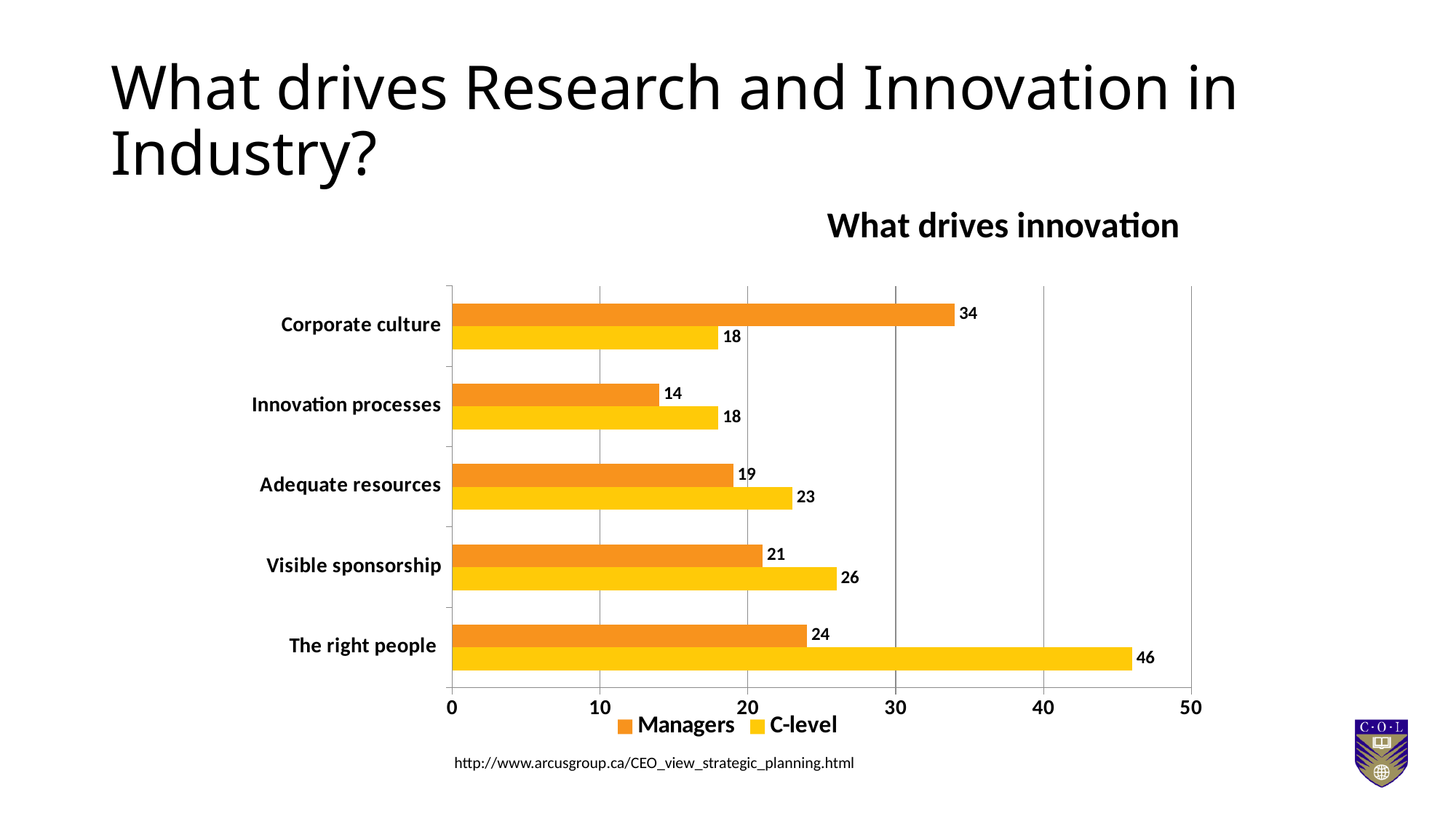
Is the Managers value for Corporate culture greater or less than 30? greater Which category has the lowest Managers value? Innovation processes What is the C-level value for The right people? 46 What is the title of the chart? What drives innovation What is the Managers value for Corporate culture? 34 What kind of chart is shown on the slide? Bar chart What is the difference between the C-level and Managers values for The right people? 22 Which category has the highest C-level value? The right people Which is larger for Visible sponsorship, the Managers value or the C-level value? C-level What is the C-level value for Adequate resources? 23 How many categories are shown on the chart? 5 How many series does the legend list? 2